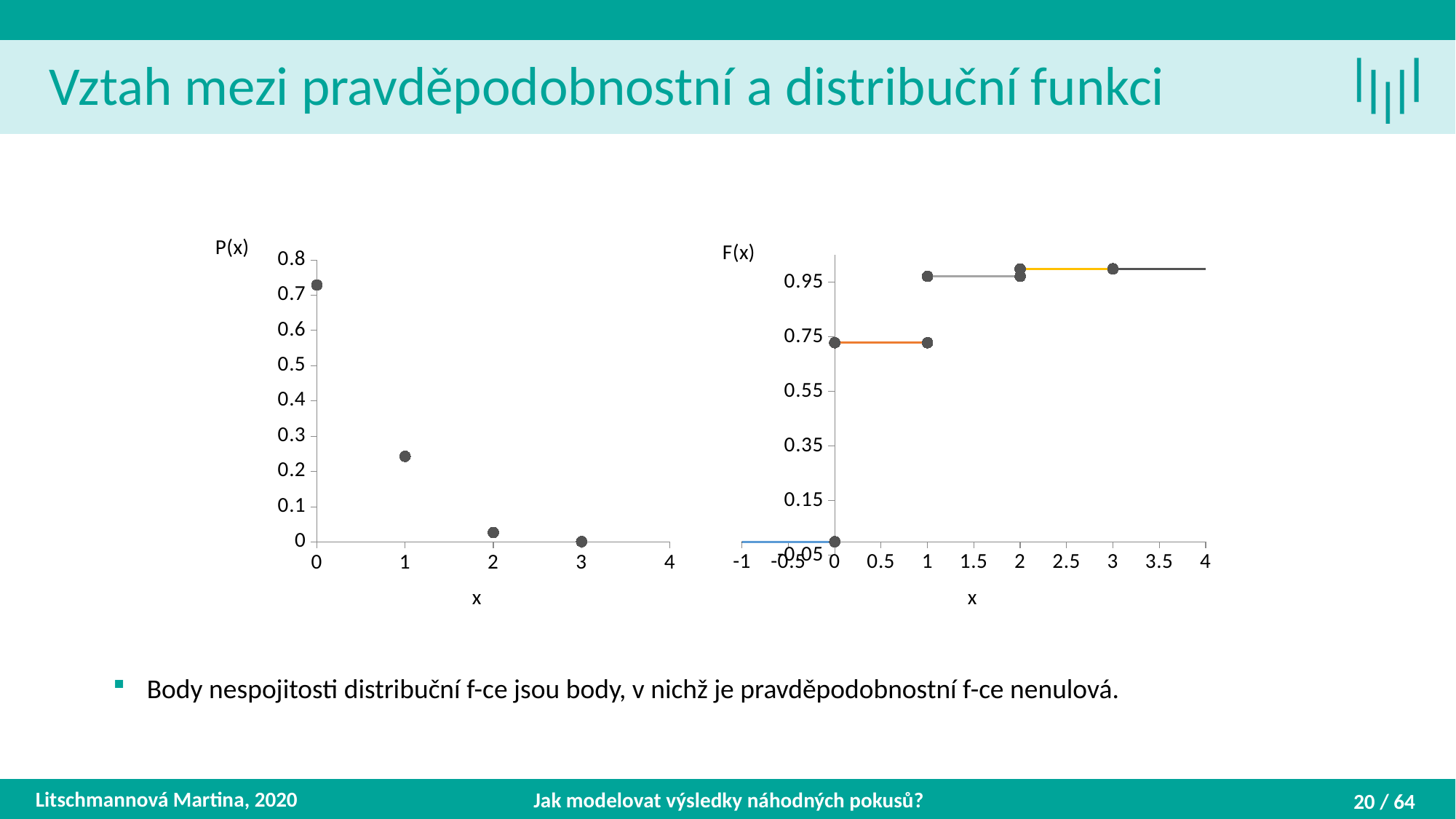
What is the label of the vertical axis of the right chart? F(x) In the left chart (P(x)), is the value for x = 0 greater or less than 0.7? greater In the left chart (P(x)), which is larger, the value at x = 0 or the value at x = 1? x = 0 What kind of chart is the left chart (P(x))? scatter chart In the left chart (P(x)), is the value for x = 2 greater or less than 0.1? less In the right chart (F(x)), is the value for x = 3 greater or less than 0.95? greater In the right chart (F(x)), do the values rise or fall as x increases? rise In the left chart (P(x)), do the values rise or fall as x increases? fall In the left chart (P(x)), which x value has the lowest P(x)? 3 In the left chart (P(x)), which x value has the highest P(x)? 0 In the left chart (P(x)), how many data points are plotted? 4